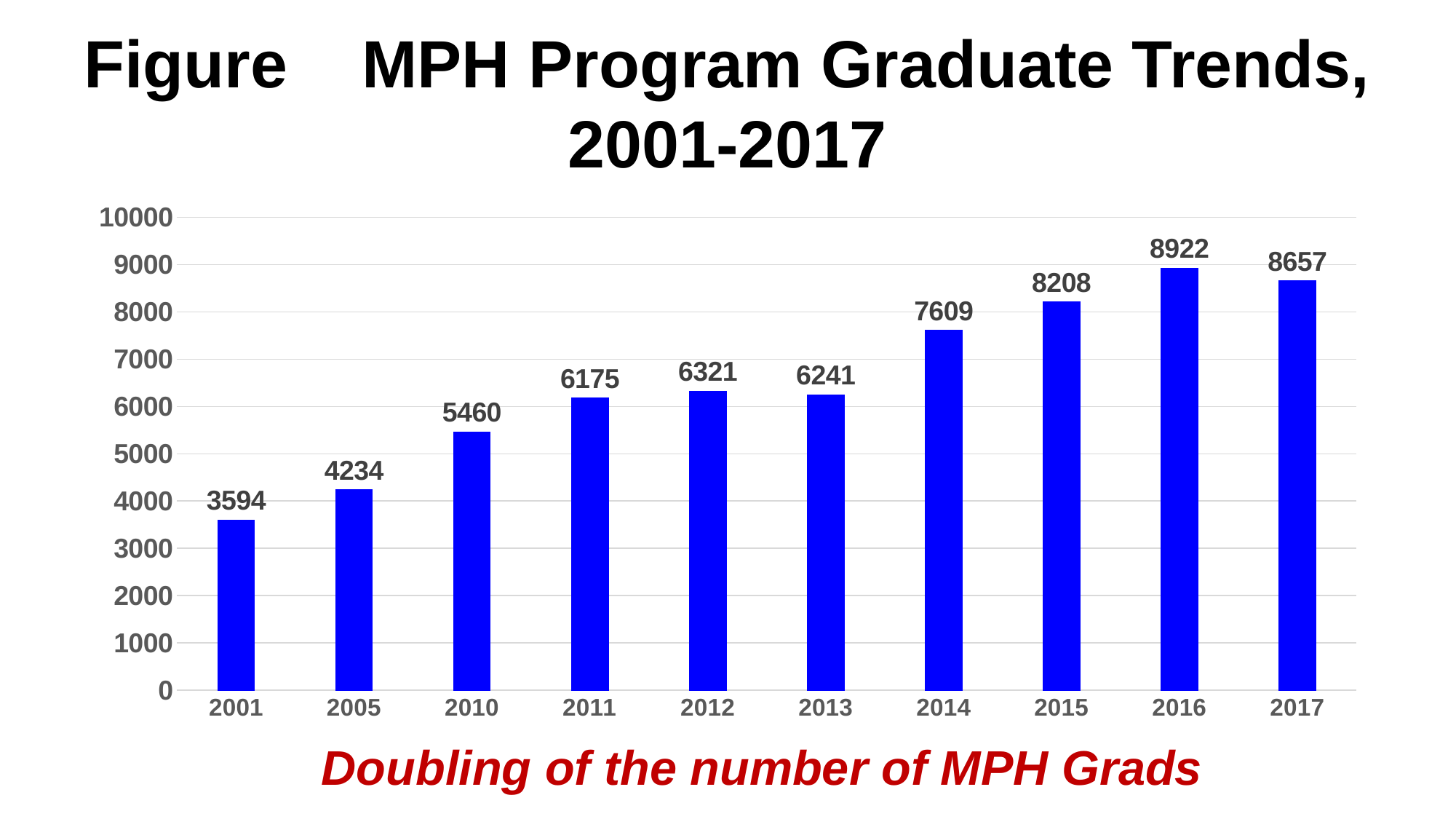
Is the value for 2015 greater or less than 8000? greater What is the difference between the values for 2001 and 2005? 640 What is the red caption below the chart? Doubling of the number of MPH Grads What is the value for 2017? 8657 What is the value for 2001? 3594 Which year has the highest value? 2016 Which year has the lowest value? 2001 How many years are shown on the x axis? 10 Which is larger, the value for 2012 or the value for 2013? 2012 What kind of chart is shown on the slide? bar chart What is the value for 2014? 7609 What is the difference between the values for 2016 and 2017? 265